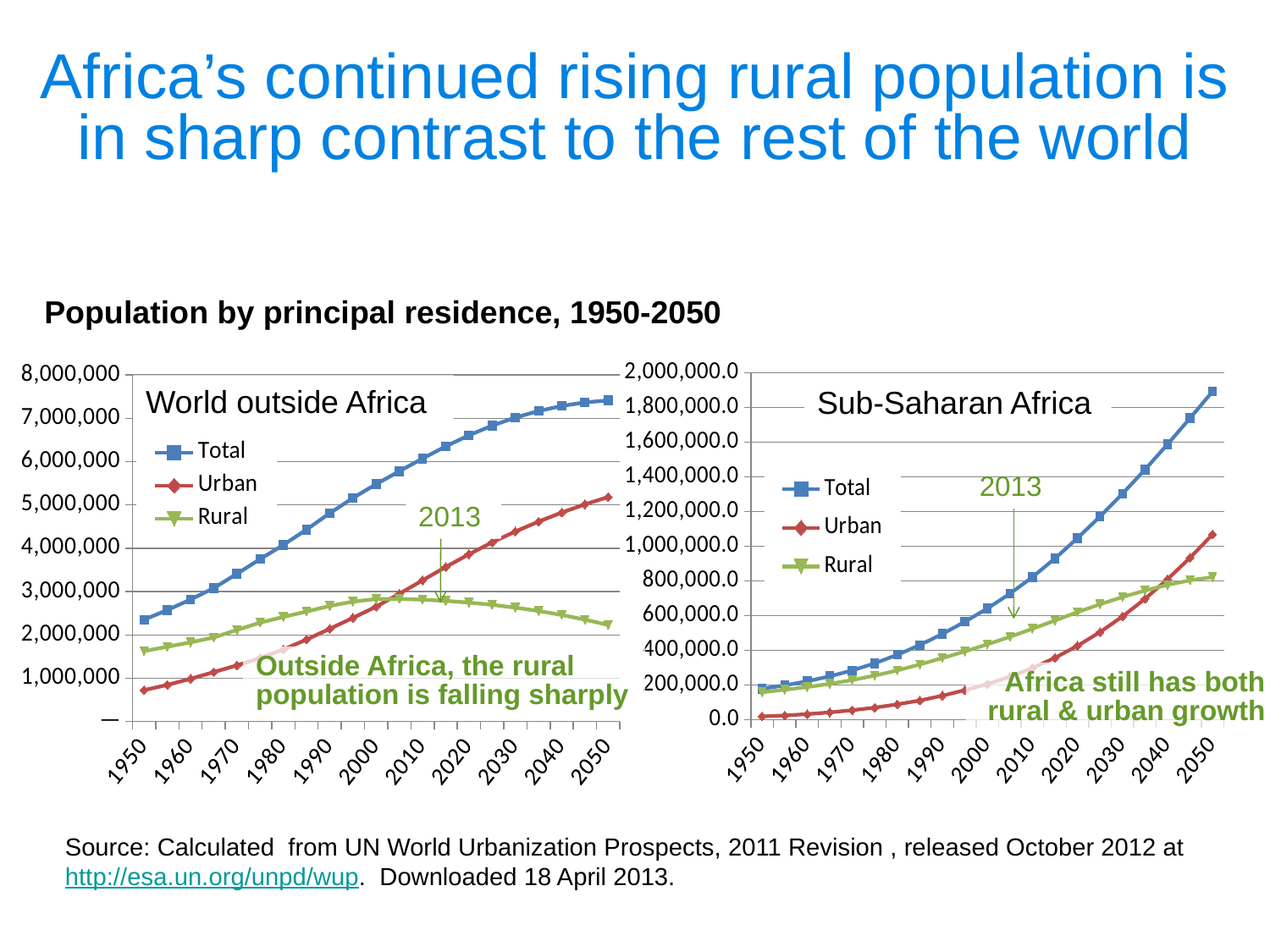
In the "Sub-Saharan Africa" chart, is the Rural value for 1950 greater or less than 200,000.0? less What kind of chart is the "World outside Africa" chart? line chart How many year labels are shown on the x axis of the "World outside Africa" chart? 11 In the "Sub-Saharan Africa" chart, does the Rural series rise or fall from 1950 to 2050? rise In the "World outside Africa" chart, is the Total value for 2050 greater or less than 7,000,000? greater How many series does the legend of the "Sub-Saharan Africa" chart list? 3 In the "World outside Africa" chart, does the Total series rise or fall from 1950 to 2050? rise In the "Sub-Saharan Africa" chart, is the Total value for 2050 greater or less than 1,800,000.0? greater In the "Sub-Saharan Africa" chart, which is larger in 2050, Urban or Rural? Urban In the "World outside Africa" chart, which is larger in 2050, Urban or Rural? Urban In the "Sub-Saharan Africa" chart, which is larger in 1950, Urban or Rural? Rural